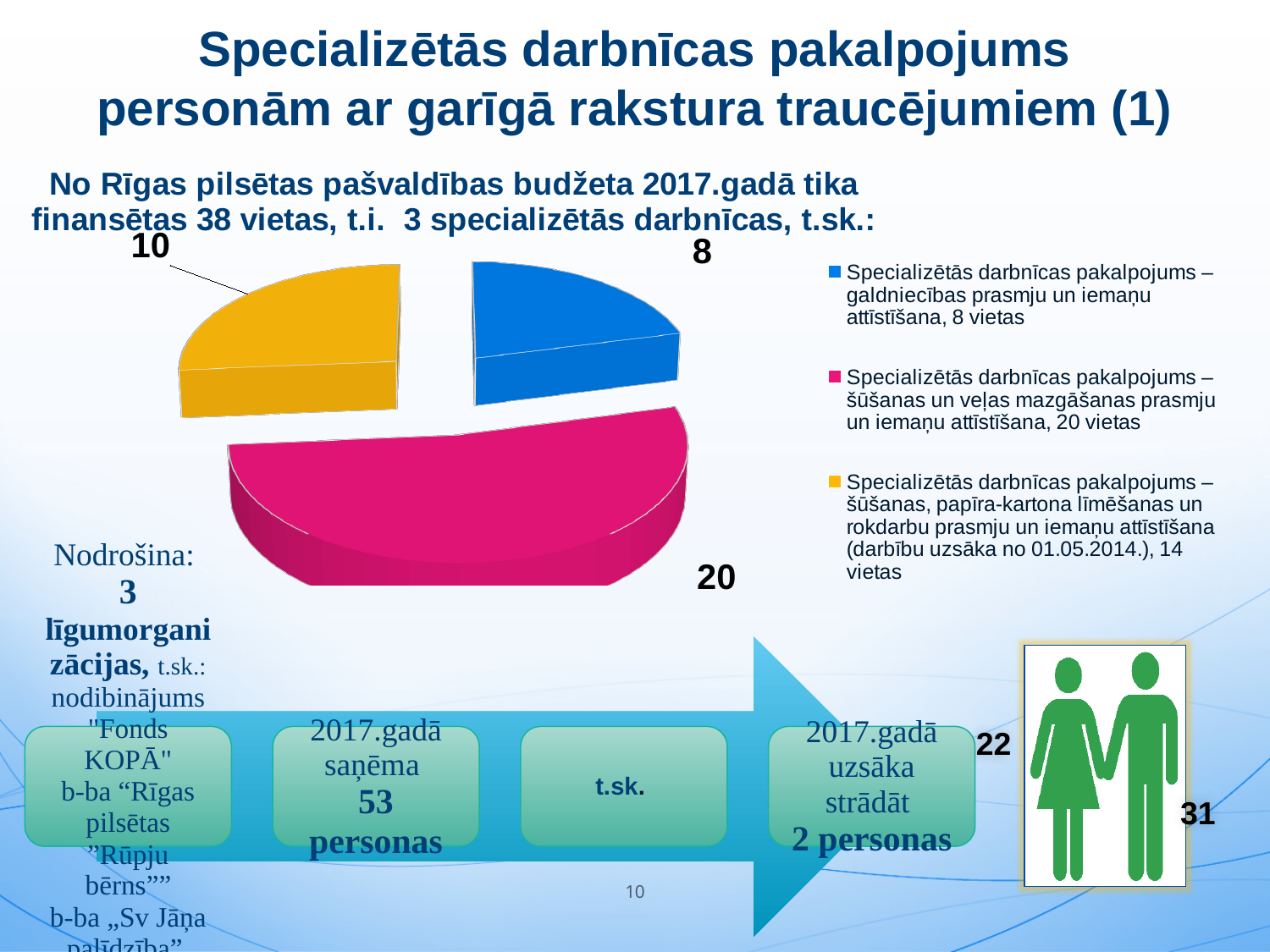
What kind of chart is shown on the slide? pie chart How many slices does the pie chart have? 3 What is the difference between the pink slice (20) and the blue slice (8)? 12 Which slice of the pie chart is the smallest? Galdniecības prasmju un iemaņu attīstīšana (8) What is the difference between the yellow slice (10) and the blue slice (8)? 2 Which is larger, the yellow slice or the blue slice? the yellow slice How many entries does the legend of the pie chart list? 3 Which slice of the pie chart is the largest? Šūšanas un veļas mazgāšanas prasmju un iemaņu attīstīšana (20) What colour is the largest slice of the pie chart? pink What value is labelled on the pink slice (šūšanas un veļas mazgāšanas prasmju un iemaņu attīstīšana)? 20 What value is labelled on the blue slice (galdniecības prasmju un iemaņu attīstīšana)? 8 What value is labelled on the yellow slice of the pie chart? 10